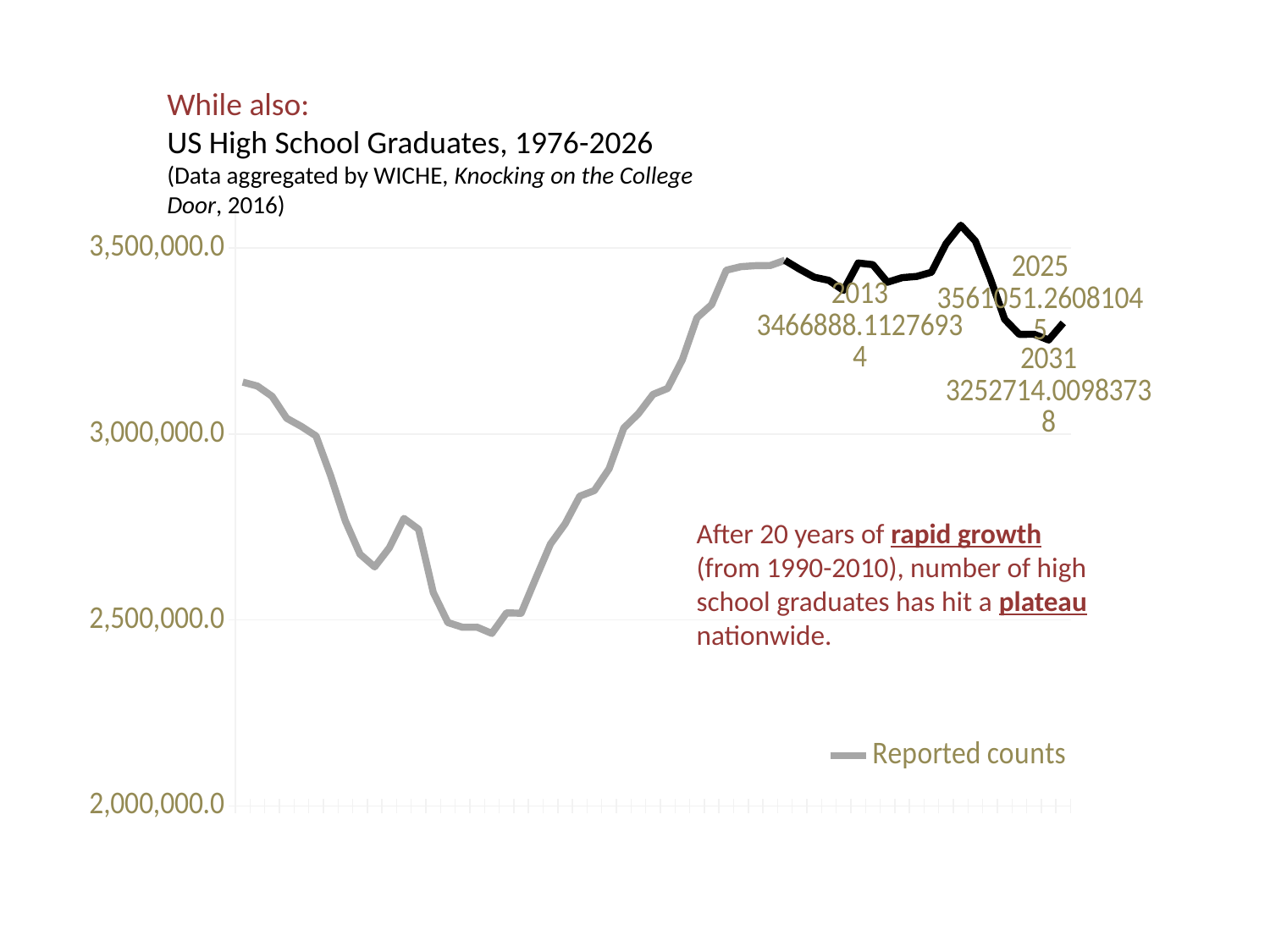
What kind of chart is shown on the slide? line chart Is the lowest point of the gray Reported counts line greater or less than 2,500,000.0? less What value is labeled for 2013 on the chart? 3466888.11276934 What is the name of the series listed in the legend? Reported counts Which is larger, the labeled value for 2025 or the labeled value for 2013? 2025 What value is labeled for 2025 on the chart? 3561051.26081045 How many series does the chart legend list? 1 Of the three labeled years (2013, 2025, 2031), which has the highest value? 2025 What is the difference between the labeled values for 2025 and 2031? 308337.25097307 Of the three labeled years (2013, 2025, 2031), which has the lowest value? 2031 What is the title of the chart? US High School Graduates, 1976-2026 What value is labeled for 2031 on the chart? 3252714.00983738